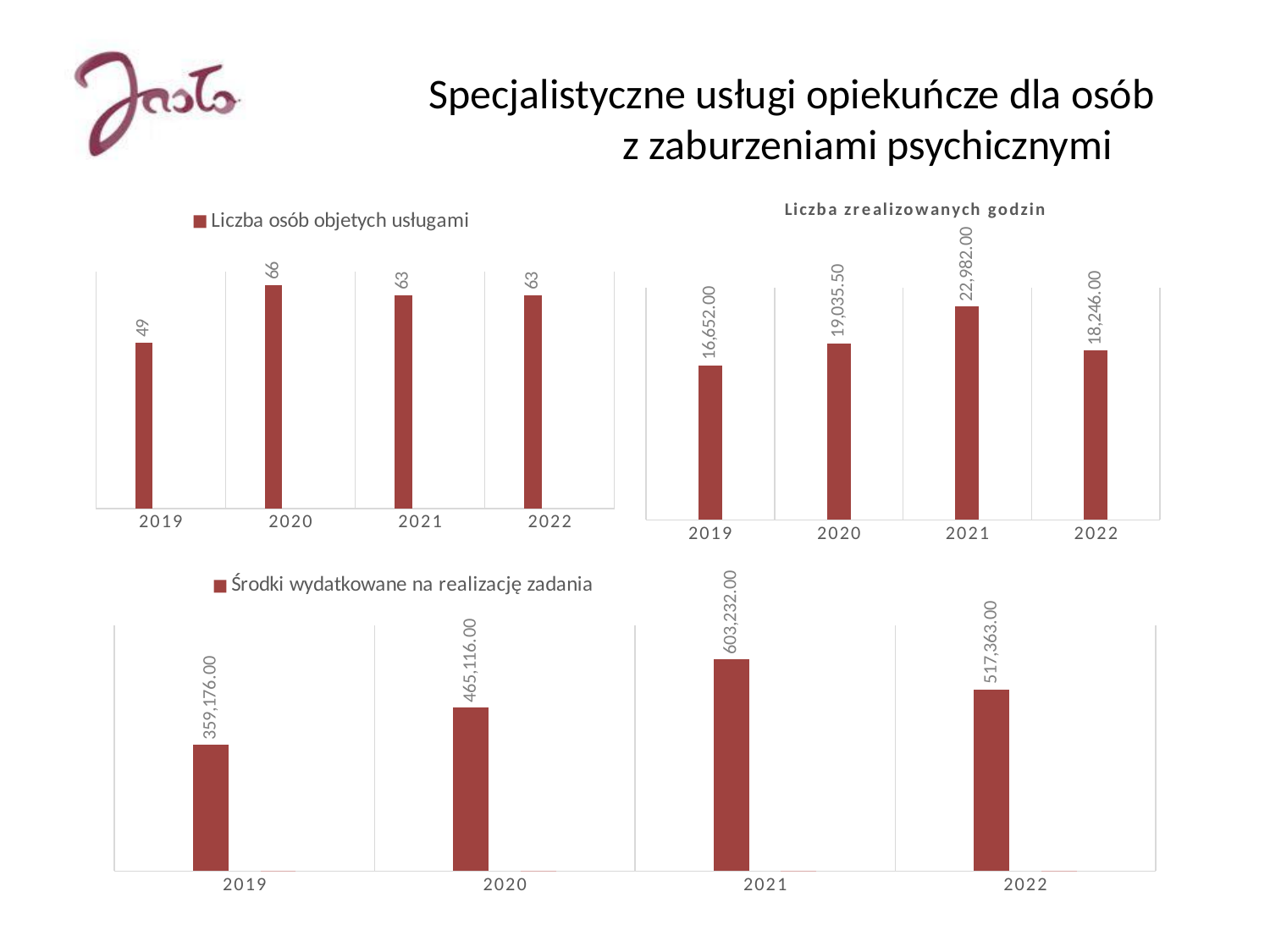
In the 'Liczba osób objetych usługami' chart, which year has the highest value? 2020 How many charts are shown on the slide? 3 What kind of chart is the 'Liczba zrealizowanych godzin' chart? Bar chart In the 'Liczba zrealizowanych godzin' chart, which year has the lowest value? 2019 In the 'Środki wydatkowane na realizację zadania' chart, what is the difference between the values for 2020 and 2019? 105,940.00 How many years are shown on the x axis of the 'Środki wydatkowane na realizację zadania' chart? 4 In the 'Środki wydatkowane na realizację zadania' chart, what is the value for 2021? 603,232.00 In the 'Środki wydatkowane na realizację zadania' chart, what is the value for 2022? 517,363.00 In the 'Liczba zrealizowanych godzin' chart, what is the value for 2020? 19,035.50 In the 'Liczba osób objetych usługami' chart, what is the value for 2019? 49 In the 'Liczba zrealizowanych godzin' chart, which is larger, the value for 2021 or the value for 2022? 2021 In the 'Liczba osób objetych usługami' chart, what is the difference between the values for 2020 and 2019? 17